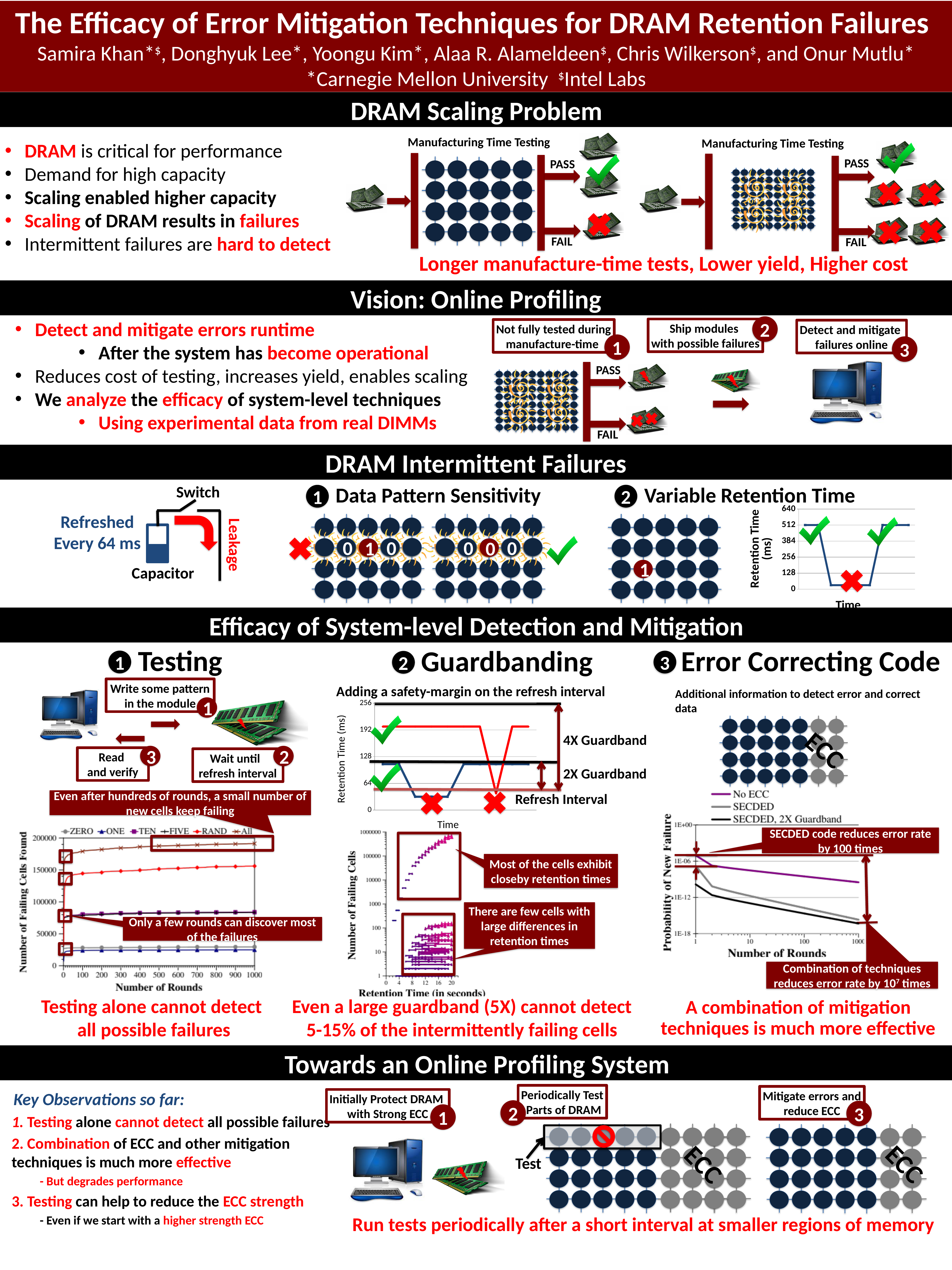
In the Testing chart, is the value for the TEN series at 1000 rounds greater or less than 100000? less In the Testing chart, what is the label of the x axis? Number of Rounds In the Testing chart, which series has the larger value at 1000 rounds, RAND or TEN? RAND In the Variable Retention Time chart, what is the highest tick shown on the Retention Time (ms) axis? 640 In the Error Correcting Code chart, which series has the lowest probability of new failure at 1000 rounds? SECDED, 2X Guardband What kind of chart is the Testing chart of failing cells found versus number of rounds? line chart In the Error Correcting Code chart, do the probability values rise or fall as the number of rounds increases? fall In the Testing chart, which series finds the highest number of failing cells? All In the Testing chart, is the value for the All series at 1000 rounds greater or less than 150000? greater In the Error Correcting Code chart (Probability of New Failure vs Number of Rounds), how many series does the legend list? 3 In the Error Correcting Code chart, which series has the highest probability of new failure at 1000 rounds? No ECC In the Testing chart (Number of Failing Cells Found vs Number of Rounds), how many series does the legend list? 6